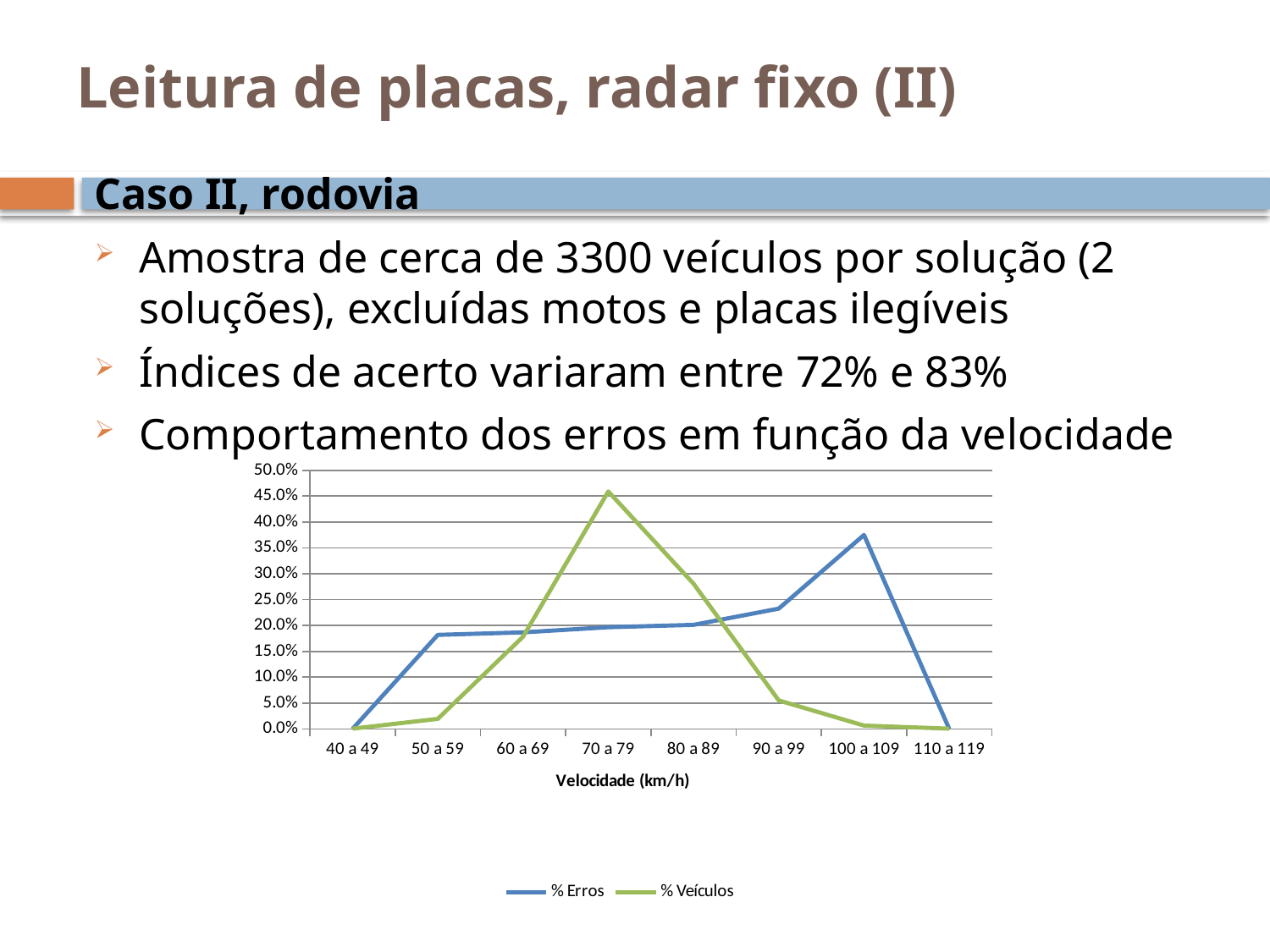
Is the value of % Erros for 50 a 59 greater or less than 15.0%? greater For the 80 a 89 category, which series has the larger value, % Erros or % Veículos? % Veículos What kind of chart is shown on the slide? line chart For the 90 a 99 category, which series has the larger value, % Erros or % Veículos? % Erros Is the value of % Veículos for 90 a 99 greater or less than 10.0%? less What is the title of the x axis of the chart? Velocidade (km/h) Which speed category has the highest value for % Veículos? 70 a 79 Which speed category has the highest value for % Erros? 100 a 109 How many speed categories are shown on the x axis of the chart? 8 Is the value of % Veículos for 70 a 79 greater or less than 40.0%? greater How many series does the chart's legend list? 2